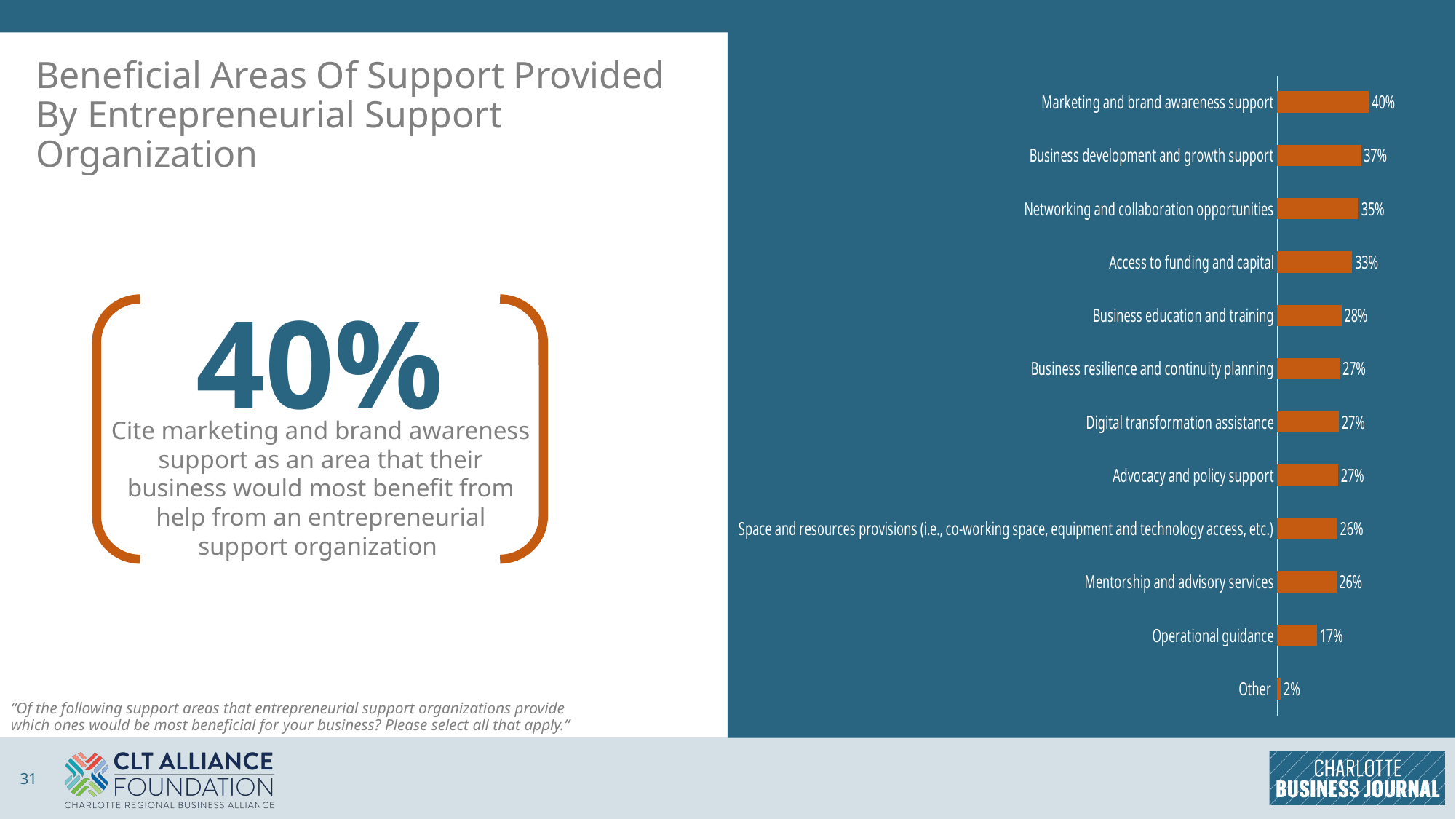
What colour are the bars in the chart? Orange What is the value shown for Space and resources provisions (i.e., co-working space, equipment and technology access, etc.)? 26% How many support areas are shown in the chart? 12 Which is larger: the value for Business education and training or the value for Mentorship and advisory services? Business education and training What is the difference between the values for Business development and growth support and Networking and collaboration opportunities? 2% What kind of chart is shown on the slide? Bar chart Which support area has the lowest value in the chart? Other What is the value shown for Operational guidance? 17% What is the difference between the values for Marketing and brand awareness support and Operational guidance? 23% Which support area has the highest value in the chart? Marketing and brand awareness support What percentage of respondents cited Marketing and brand awareness support as a beneficial area? 40% What is the value shown for Access to funding and capital? 33%